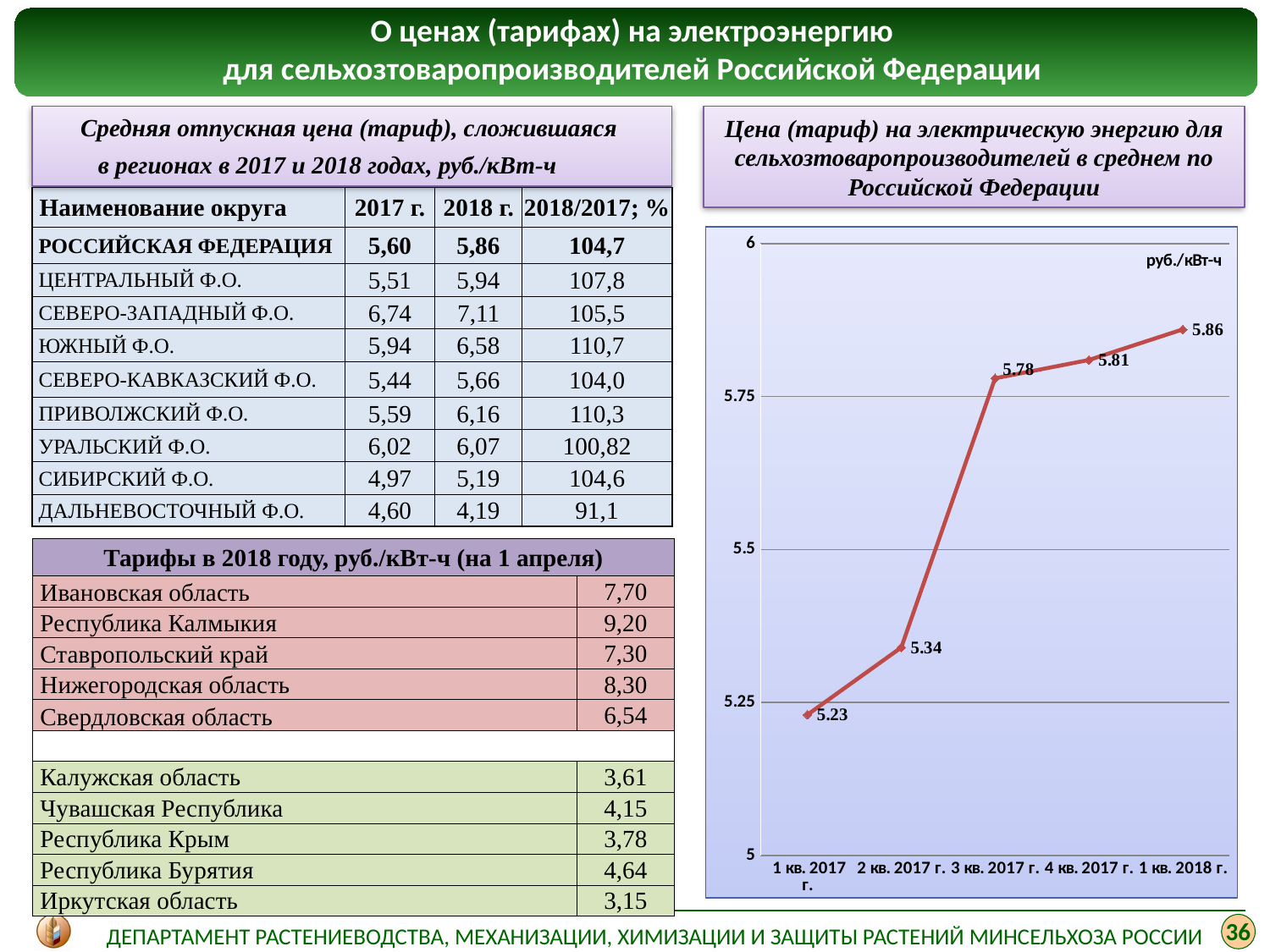
What is the value for 1 кв. 2017 г.? 5.23 What kind of chart is shown on the slide? line chart What is the difference between the values for 3 кв. 2017 г. and 2 кв. 2017 г.? 0.44 How many data points are plotted on the chart? 5 Which is larger, the value for 4 кв. 2017 г. or the value for 3 кв. 2017 г.? 4 кв. 2017 г. What is the value for 3 кв. 2017 г.? 5.78 What is the value for 1 кв. 2018 г.? 5.86 Which quarter has the lowest value? 1 кв. 2017 г. Do the values rise or fall from 1 кв. 2017 г. to 1 кв. 2018 г.? rise What is the value for 2 кв. 2017 г.? 5.34 Which quarter has the highest value? 1 кв. 2018 г. Is the value for 2 кв. 2017 г. greater or less than 5.5? less